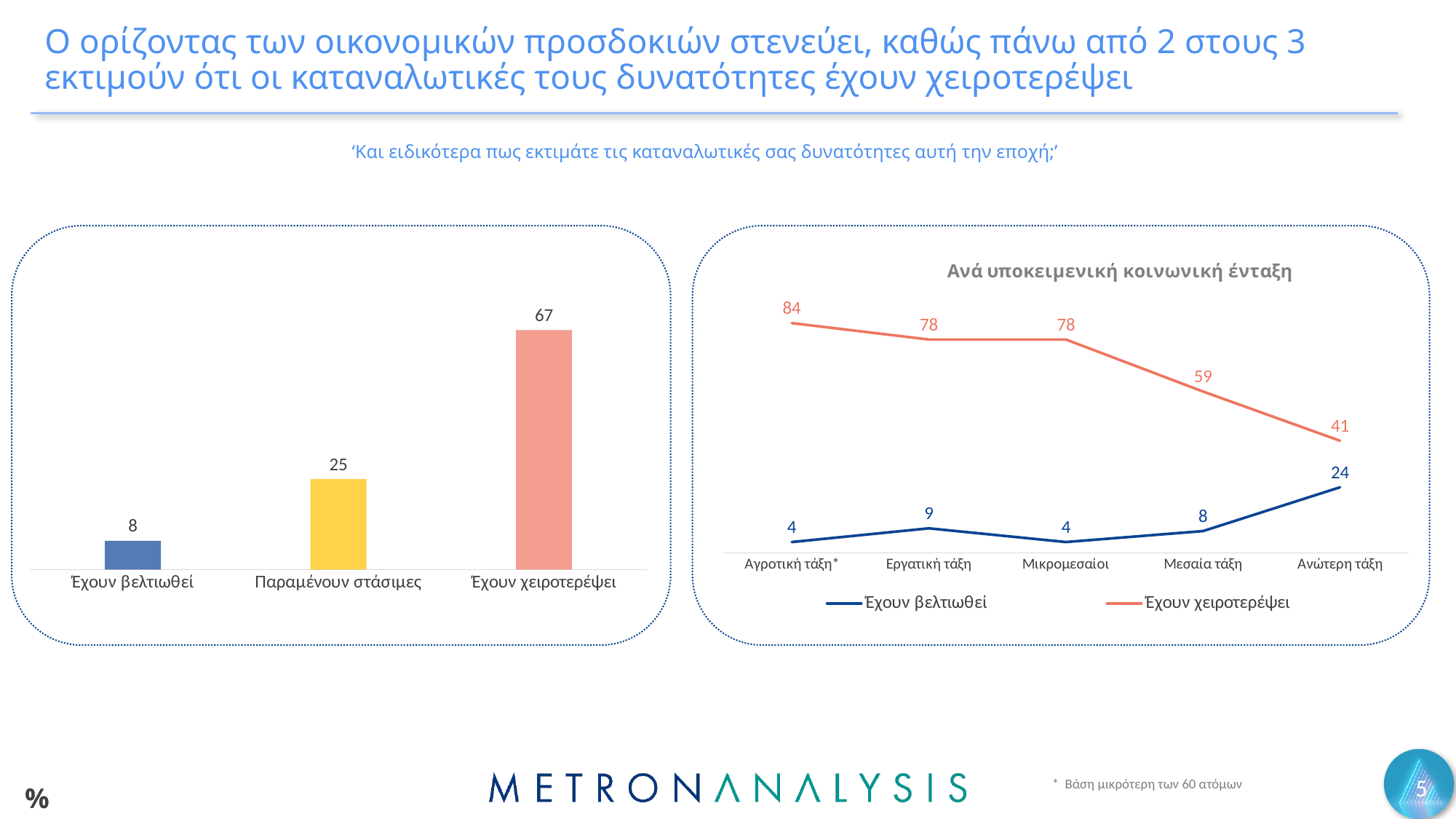
In the bar chart on the left, how many categories are shown? 3 In the bar chart on the left, what is the difference between Έχουν χειροτερέψει and Παραμένουν στάσιμες? 42 In the chart titled 'Ανά υποκειμενική κοινωνική ένταξη', what is the difference between Έχουν χειροτερέψει and Έχουν βελτιωθεί for Μεσαία τάξη? 51 In the bar chart on the left, what is the value for Έχουν χειροτερέψει? 67 In the chart titled 'Ανά υποκειμενική κοινωνική ένταξη', what is the value of Έχουν χειροτερέψει for Αγροτική τάξη*? 84 In the chart titled 'Ανά υποκειμενική κοινωνική ένταξη', how many series does the legend list? 2 In the bar chart on the left, which category has the lowest value? Έχουν βελτιωθεί In the chart titled 'Ανά υποκειμενική κοινωνική ένταξη', what is the value of Έχουν βελτιωθεί for Ανώτερη τάξη? 24 What kind of chart is the chart on the left? bar chart What kind of chart is the chart titled 'Ανά υποκειμενική κοινωνική ένταξη'? line chart In the chart titled 'Ανά υποκειμενική κοινωνική ένταξη', which category has the lowest value for Έχουν χειροτερέψει? Ανώτερη τάξη In the chart titled 'Ανά υποκειμενική κοινωνική ένταξη', does the Έχουν χειροτερέψει line rise or fall from Αγροτική τάξη* to Ανώτερη τάξη? fall